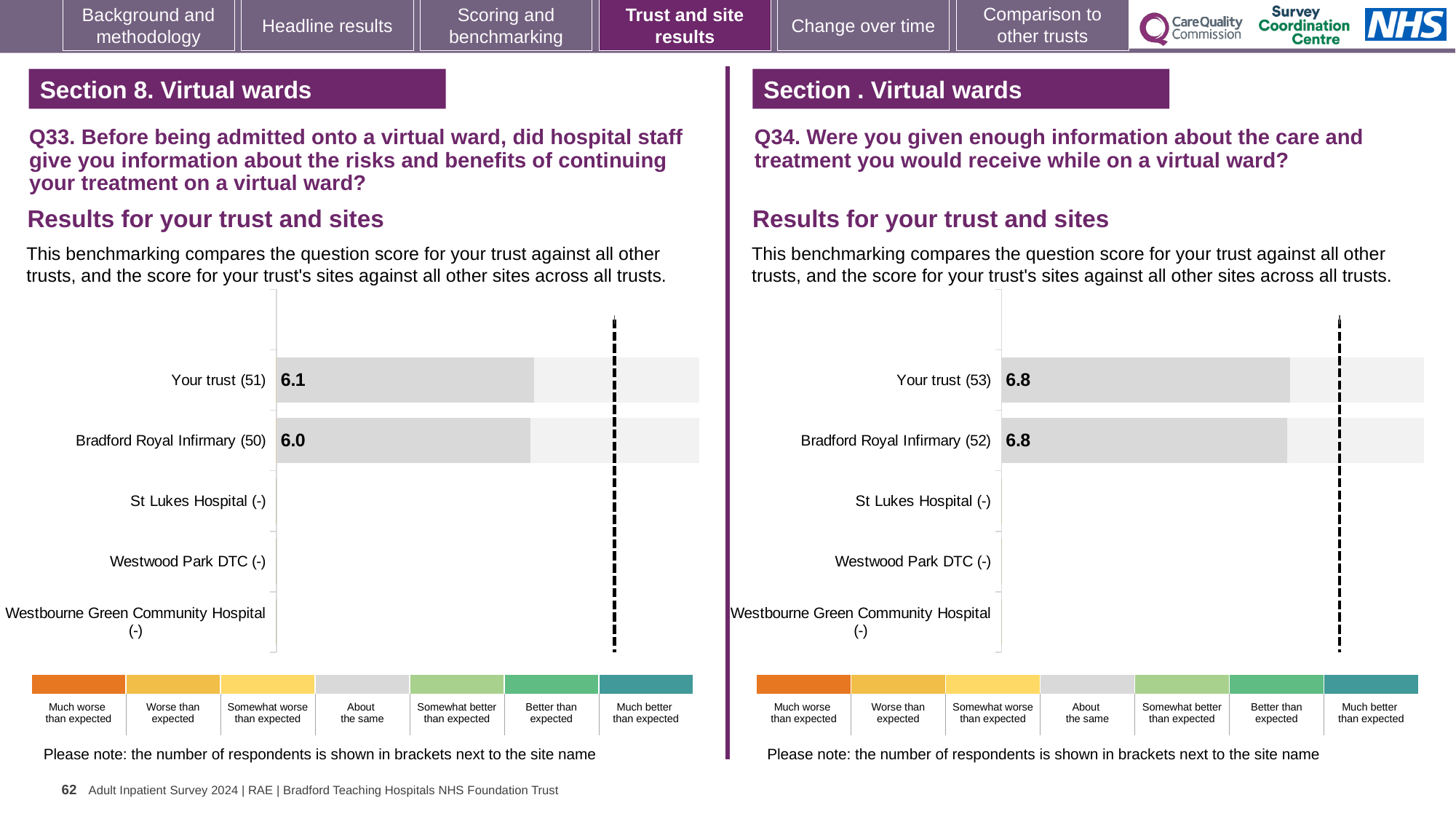
On the Q33 chart (left), how many respondents are shown in brackets for Your trust? 51 On the Q33 chart (left), how many site/trust categories are listed on the vertical axis? 5 On the Q34 chart (right), is the score for Your trust greater or less than the score for Bradford Royal Infirmary, or are they equal? Equal On the Q33 chart (left), what is the difference between the score for Your trust and the score for Bradford Royal Infirmary? 0.1 On the Q33 chart (left), what is the score for Bradford Royal Infirmary? 6.0 On the Q33 chart (left), what is the score for Your trust? 6.1 On the Q33 chart (left), which has the higher score, Your trust or Bradford Royal Infirmary? Your trust On the Q34 chart (right), what is the score for Bradford Royal Infirmary? 6.8 What kind of chart is the Q34 chart (right)? Bar chart On the Q34 chart (right), what is the score for Your trust? 6.8 On the Q34 chart (right), how many respondents are shown in brackets for Bradford Royal Infirmary? 52 On the Q34 chart (right), how many site/trust categories are listed on the vertical axis? 5